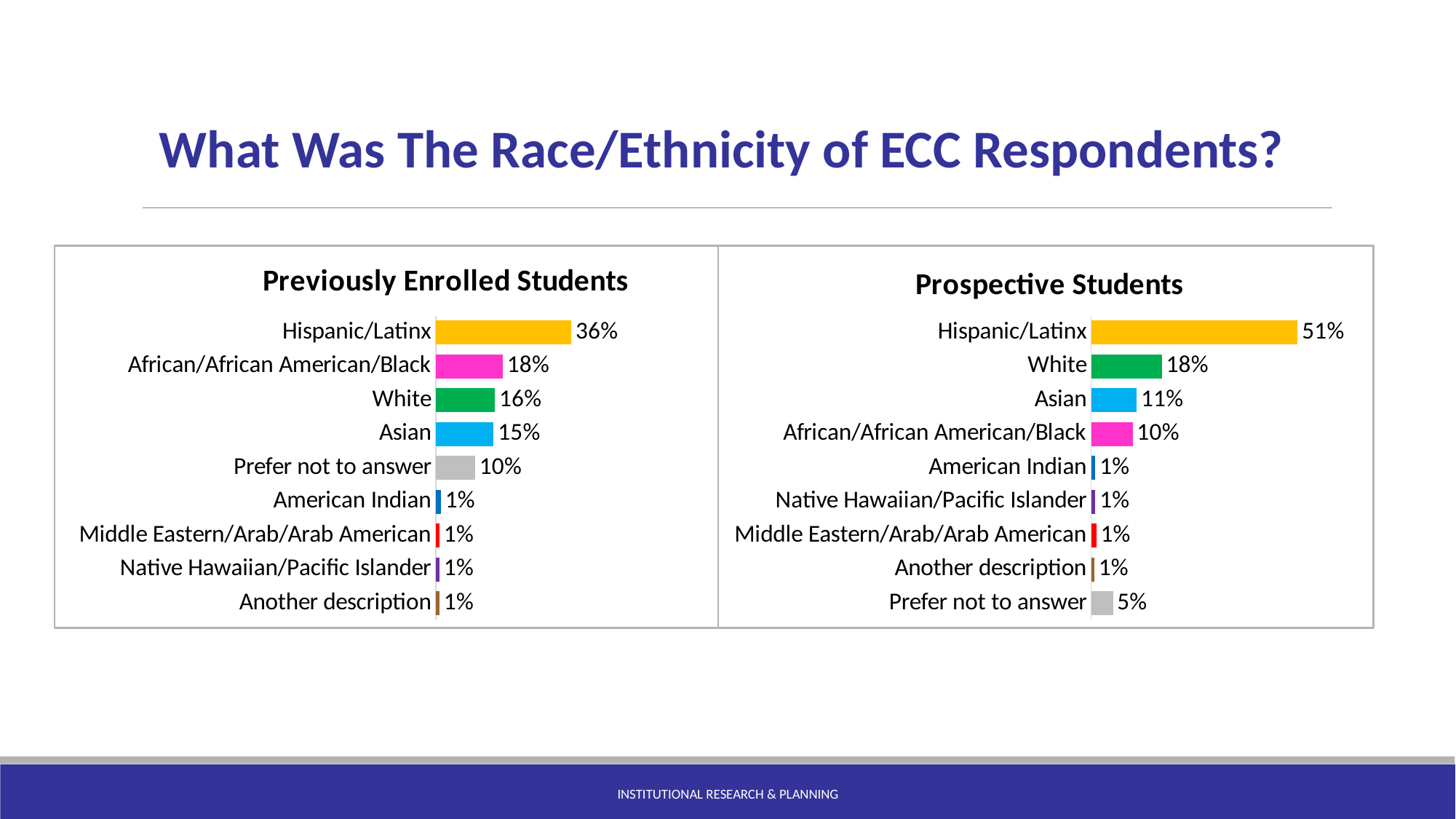
In the Prospective Students chart, which category has the highest value? Hispanic/Latinx In the Previously Enrolled Students chart, what is the value for Hispanic/Latinx? 36% In the Prospective Students chart, which is larger, Asian or Prefer not to answer? Asian What is the title of the chart on the left side of the slide? Previously Enrolled Students In the Prospective Students chart, what is the value for Prefer not to answer? 5% What kind of chart is the Prospective Students chart? Bar chart In the Prospective Students chart, what is the value for Asian? 11% In the Prospective Students chart, what is the difference between White and African/African American/Black? 8% In the Previously Enrolled Students chart, which is larger, White or Asian? White In the Previously Enrolled Students chart, what is the difference between Hispanic/Latinx and African/African American/Black? 18% In the Previously Enrolled Students chart, what is the value for Prefer not to answer? 10% How many categories are shown in the Previously Enrolled Students chart? 9